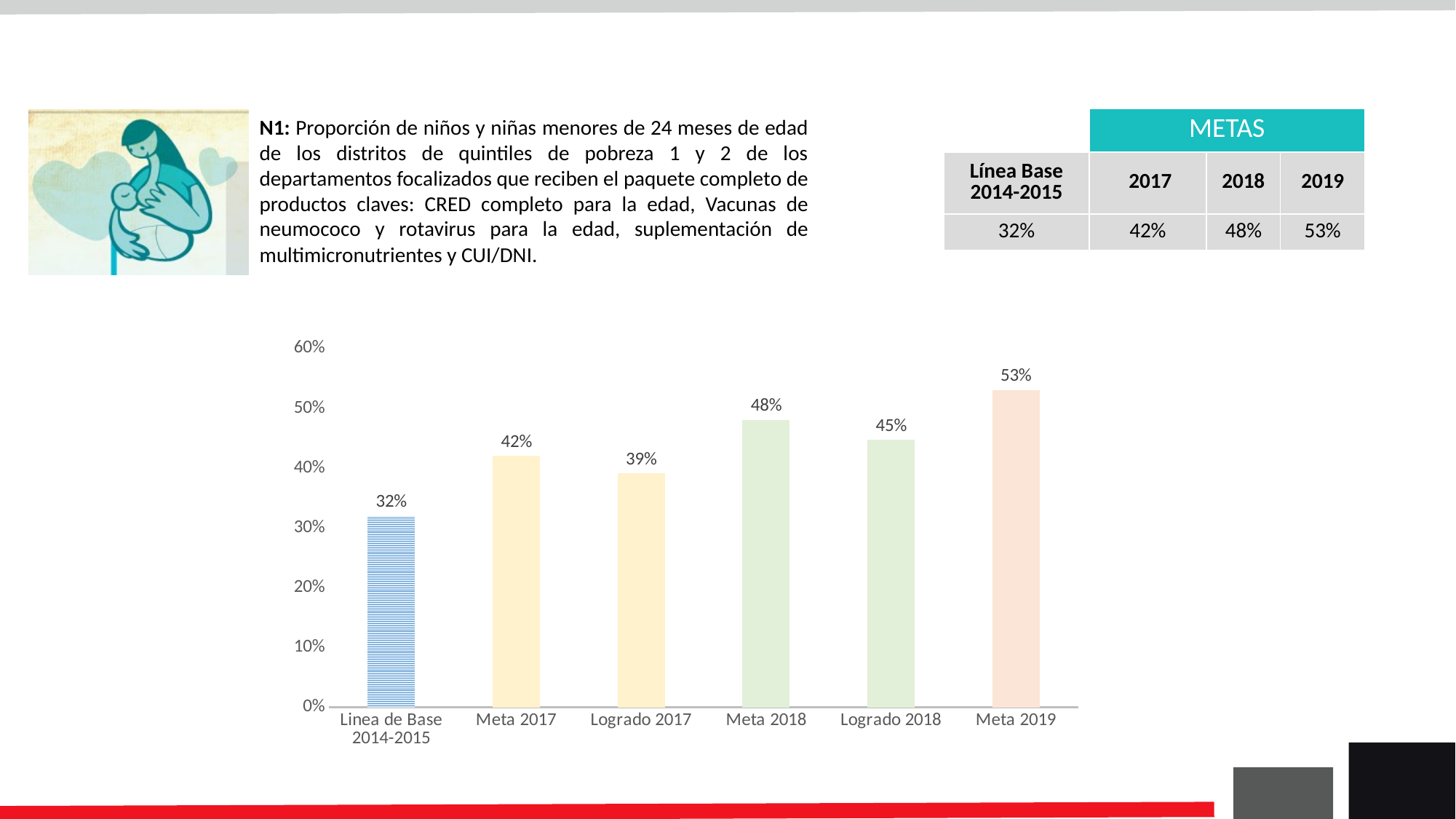
What is the value for Logrado 2017? 39% What is the value for Meta 2017? 42% What is the difference between Meta 2019 and Linea de Base 2014-2015? 21% Which category has the highest value? Meta 2019 How many categories are shown on the x axis? 6 Which is larger, Meta 2017 or Logrado 2017? Meta 2017 What is the difference between Meta 2018 and Logrado 2018? 3% What is the value for Logrado 2018? 45% What kind of chart is shown on the slide? Bar chart Which category has the lowest value? Linea de Base 2014-2015 What is the value for Linea de Base 2014-2015? 32% What is the highest value shown on the y axis? 60%